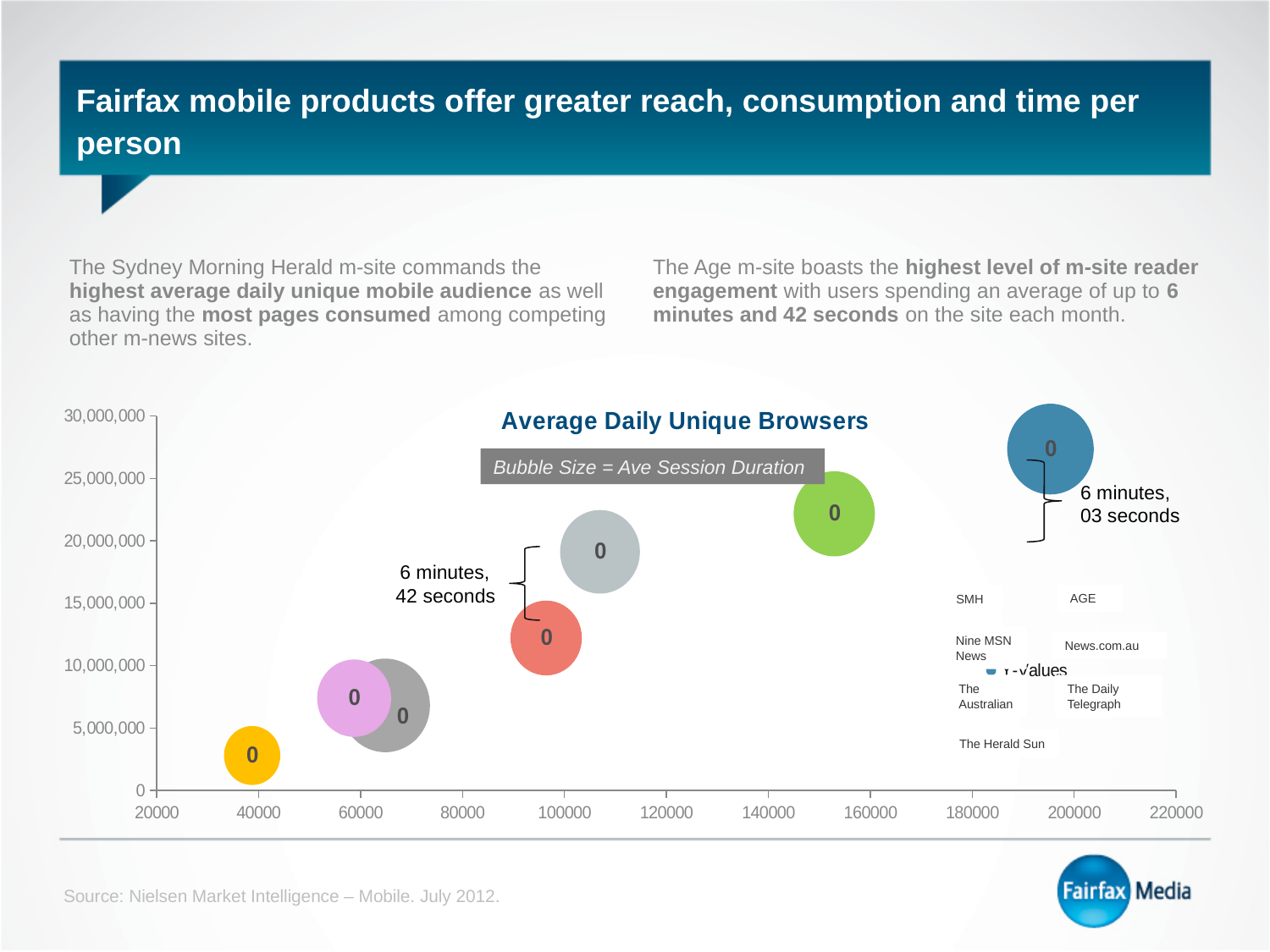
Which bubble is positioned highest on the vertical axis: the blue bubble or the green bubble? the blue bubble Is the vertical position of the bubble annotated "6 minutes, 03 seconds" greater or less than 25,000,000? greater What kind of chart is shown on the slide? Bubble chart Which bubble is positioned lowest on the vertical axis? the yellow bubble What is the title of the chart? Average Daily Unique Browsers How many bubbles are plotted on the chart? 7 Is the horizontal position of the bubble annotated "6 minutes, 03 seconds" greater or less than 180000? greater Is the vertical position of the yellow bubble greater or less than 5,000,000? less According to the chart's note, what does the bubble size represent? Ave Session Duration